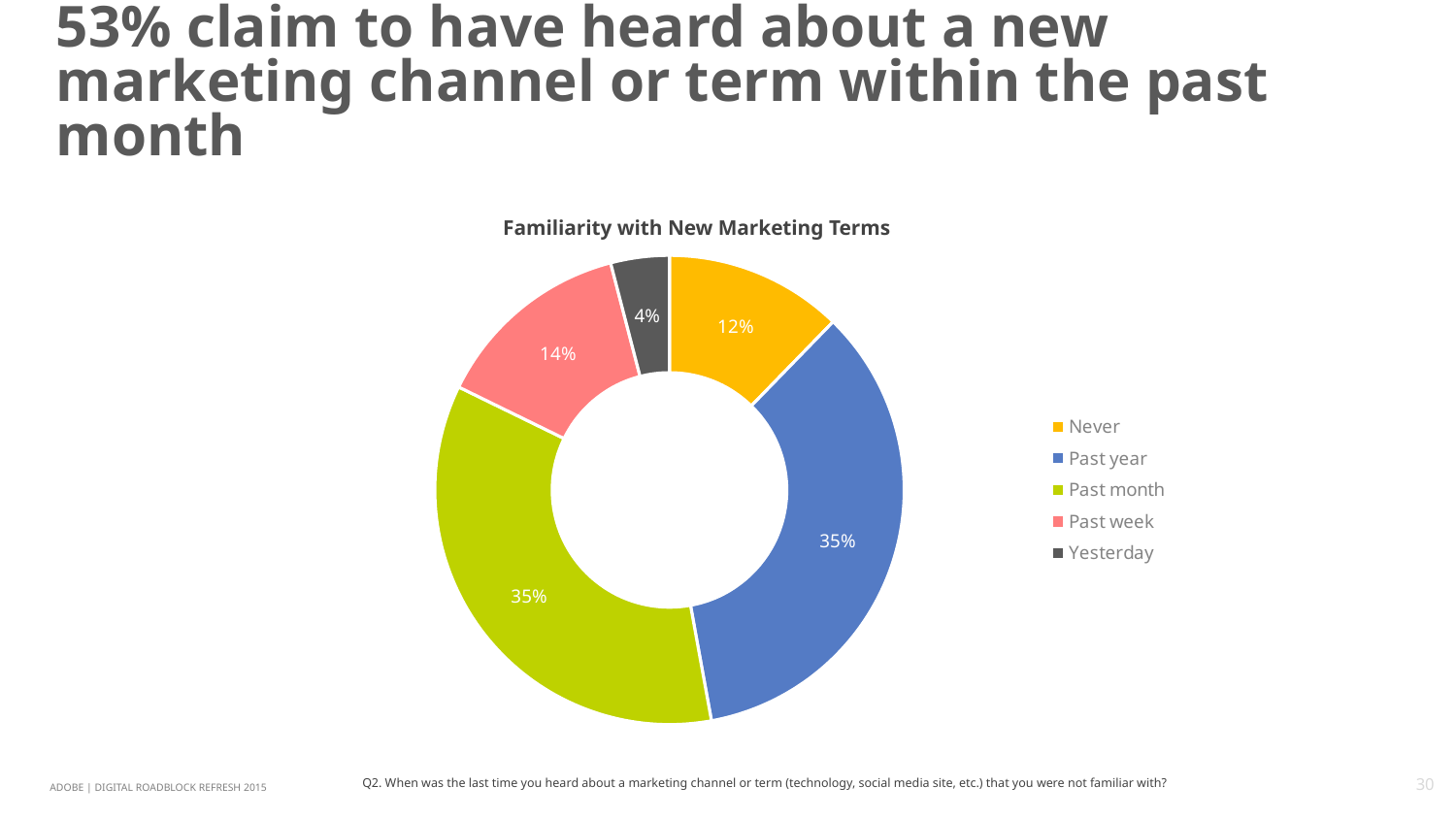
Which is larger, the slice for "Never" or the slice for "Past week"? Past week What percentage of respondents answered "Never" in the Familiarity with New Marketing Terms chart? 12% What percentage is shown for "Past year"? 35% What is the difference in percentage points between "Past week" and "Yesterday"? 10 What is the title of the chart? Familiarity with New Marketing Terms What kind of chart is shown on the slide? Doughnut chart What value is shown for "Yesterday" in the chart? 4% Which category has the smallest slice in the chart? Yesterday How many categories does the chart show? 5 What colour is the "Past month" slice in the chart? Green What is the difference in percentage points between "Past year" and "Never"? 23 What share of the doughnut chart is labelled "Past week"? 14%